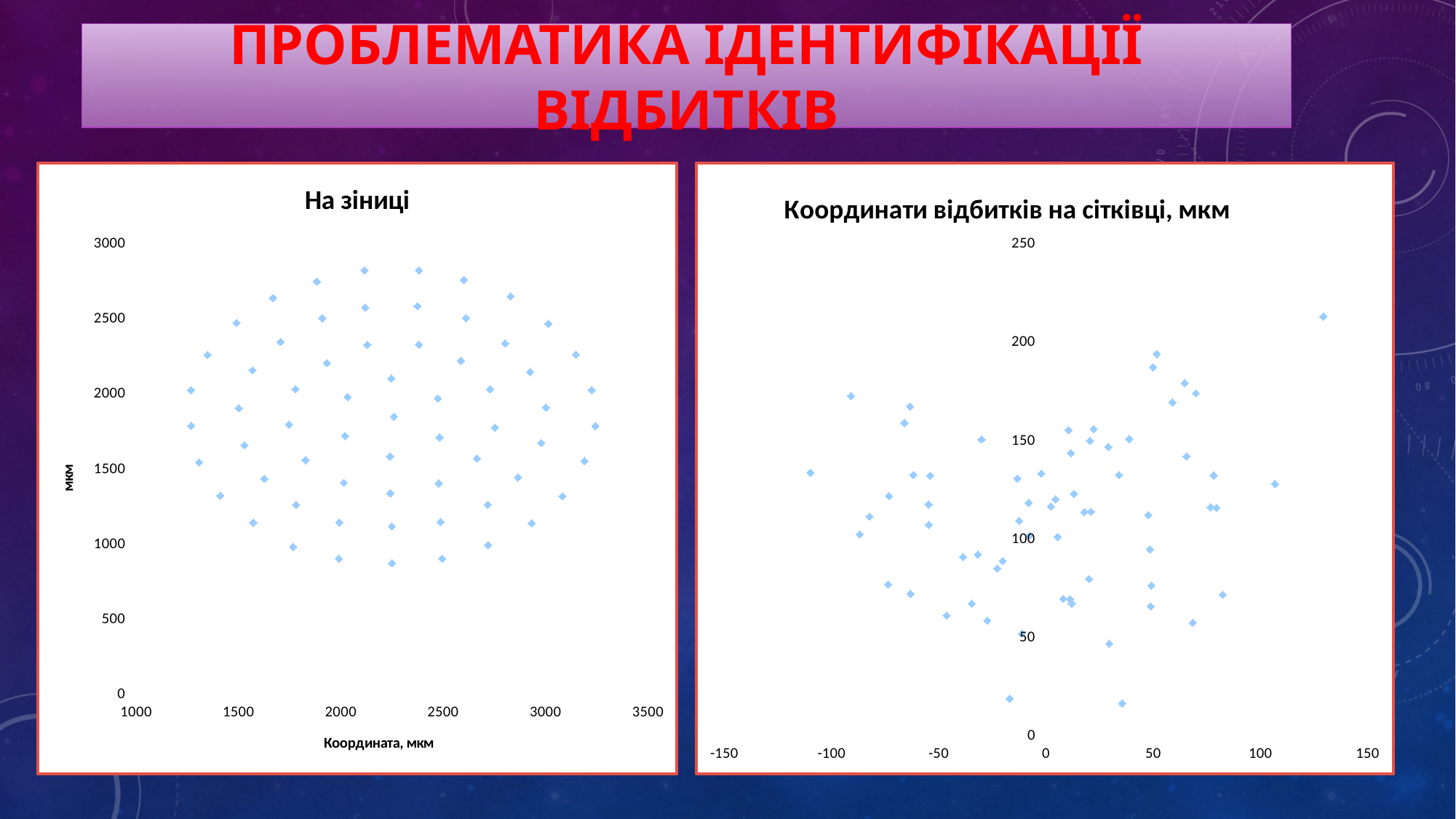
What kind of chart is the chart titled "На зіниці"? scatter chart What is the title of the chart on the left of the slide? На зіниці In the chart titled "Координати відбитків на сітківці, мкм", what is the lowest value shown on the x axis? -150 In the chart titled "На зіниці", what is the highest value shown on the x axis? 3500 What is the x-axis label of the chart titled "На зіниці"? Координата, мкм In the chart titled "На зіниці", is the y value of the lowest point greater or less than 1000? less In the chart titled "На зіниці", is the y value of the highest point greater or less than 2500? greater In the chart titled "Координати відбитків на сітківці, мкм", is the y value of the lowest point greater or less than 50? less In the chart titled "Координати відбитків на сітківці, мкм", what is the highest value shown on the y axis? 250 How many charts are shown on the slide? 2 What kind of chart is the chart titled "Координати відбитків на сітківці, мкм"? scatter chart